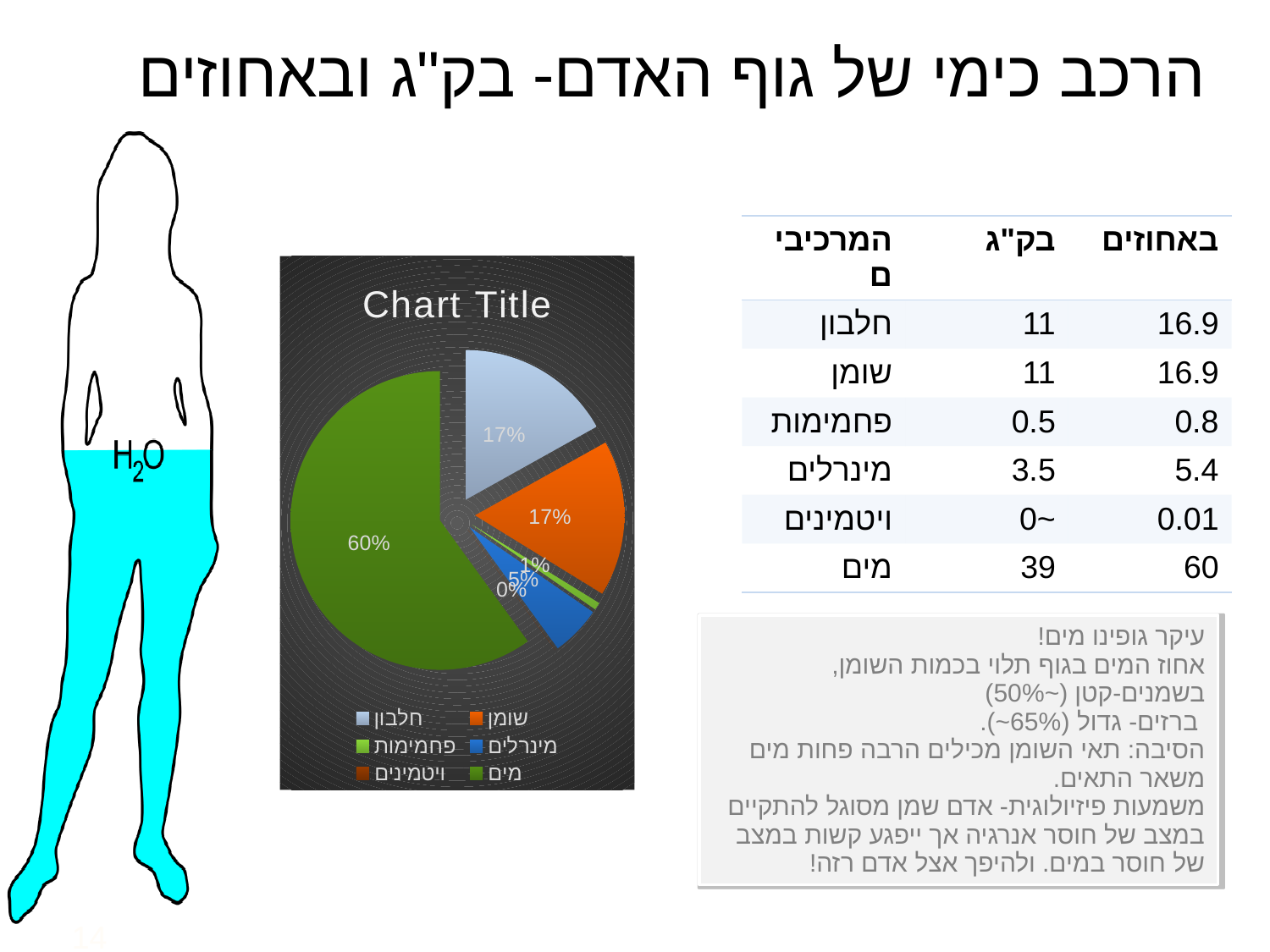
Which is larger in the pie chart, the slice for מינרלים or the slice for פחמימות? מינרלים What percentage does the pie chart show for חלבון? 17% What is the difference between the percentages for מים and חלבון in the pie chart? 43% What percentage does the pie chart show for שומן? 17% Which category has the largest slice of the pie chart? מים What colour is the slice for מים in the pie chart? green What percentage does the pie chart show for מינרלים? 5% Which category has the smallest slice of the pie chart? ויטמינים What kind of chart is shown on the slide? pie chart What is the title of the chart? Chart Title What percentage does the pie chart show for מים? 60% How many entries does the chart legend list? 6